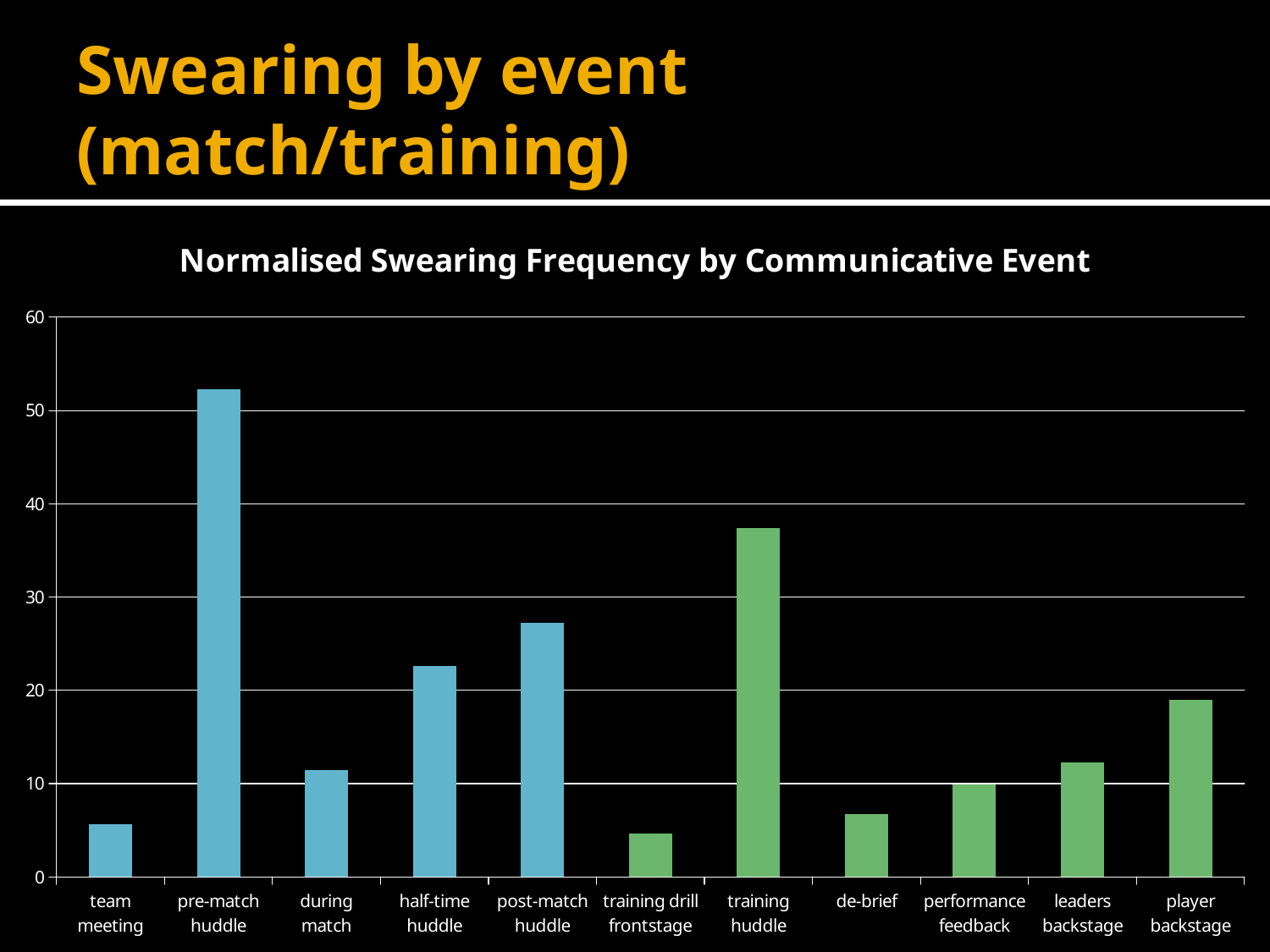
Which communicative event has the highest normalised swearing frequency? pre-match huddle Which is larger, the value for pre-match huddle or the value for training huddle? pre-match huddle Which is larger, the value for half-time huddle or the value for post-match huddle? post-match huddle How many communicative events (categories) are plotted on the chart? 11 Which is larger, the value for leaders backstage or the value for player backstage? player backstage Is the value for pre-match huddle greater or less than 50? greater Is the value for training huddle greater or less than 40? less Is the value for team meeting greater or less than 10? less What kind of chart is shown on the slide? bar chart What is the title of the chart? Normalised Swearing Frequency by Communicative Event